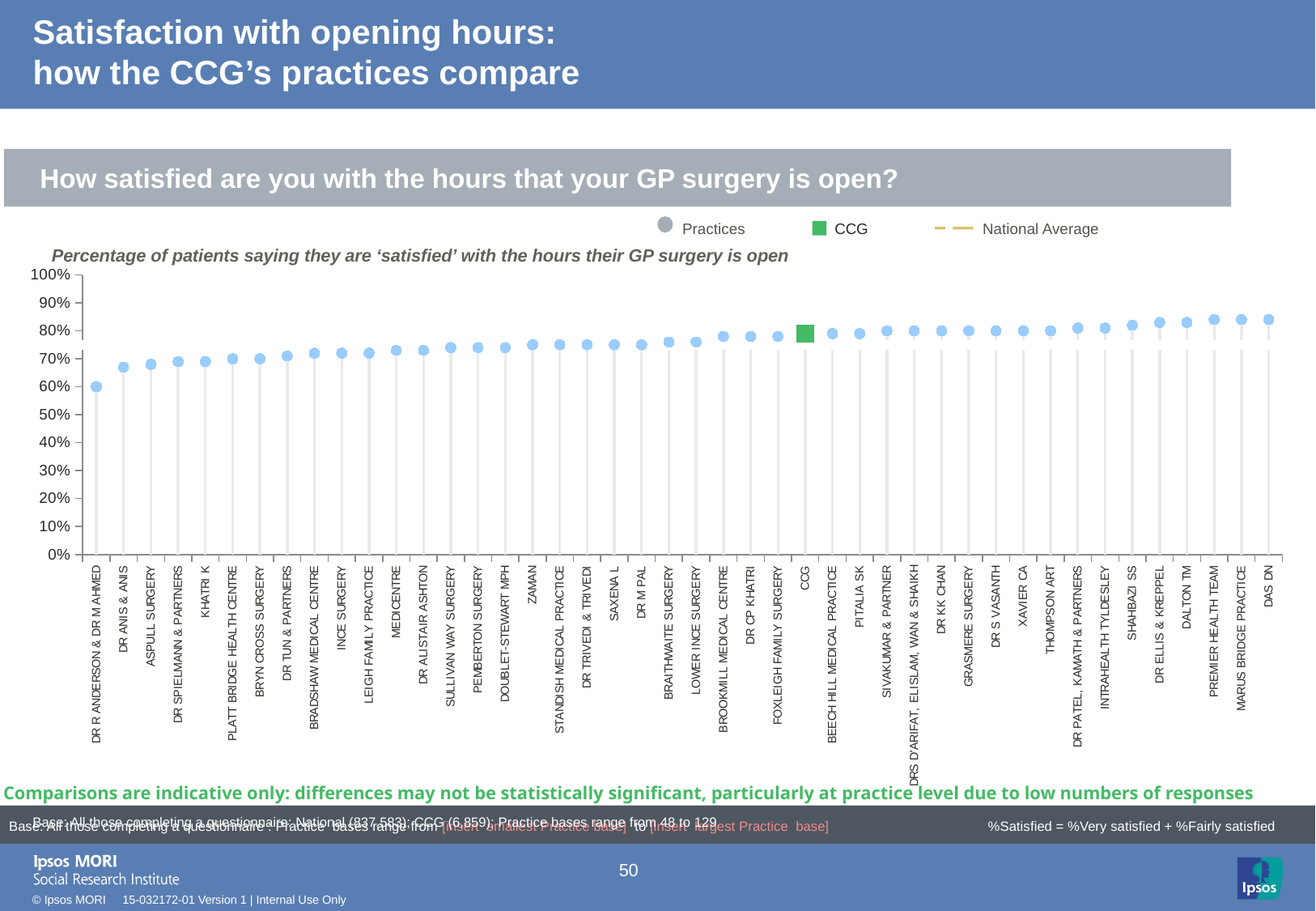
Do the values rise or fall moving from left to right along the x axis? rise Which has a lower satisfaction percentage, ASPULL SURGERY or PREMIER HEALTH TEAM? ASPULL SURGERY How many entries does the legend list? 3 What colour is the CCG marker in the chart? Green Which has a higher satisfaction percentage, DAS DN or DR ANIS & ANIS? DAS DN Is the value for MEDICENTRE greater or less than 60%? greater Is the value for CCG greater or less than 70%? greater Is the value for DAS DN greater or less than 80%? greater What question is the chart based on, as shown in the grey banner? How satisfied are you with the hours that your GP surgery is open? Which practice has the lowest percentage of patients satisfied with opening hours? DR R ANDERSON & DR M AHMED